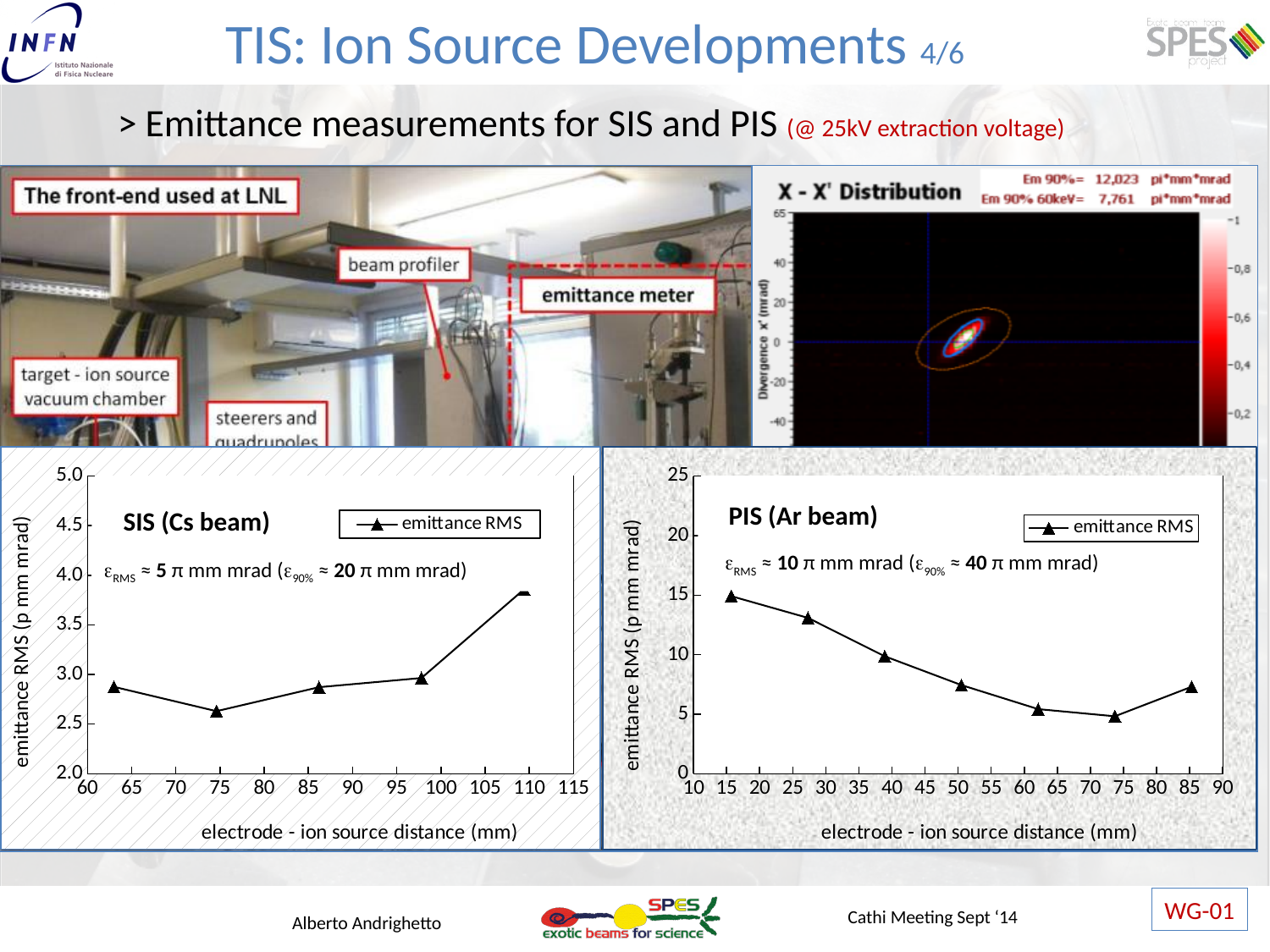
How many data points are plotted in the SIS (Cs beam) chart? 5 In the SIS (Cs beam) chart, is the highest emittance RMS found at the smallest or the largest electrode - ion source distance? largest What is the legend entry shown in the SIS (Cs beam) chart? emittance RMS What is the x-axis title of the PIS (Ar beam) chart? electrode - ion source distance (mm) In the PIS (Ar beam) chart, does the emittance RMS rise or fall as the distance increases from about 15 mm to about 75 mm? fall In the PIS (Ar beam) chart, is the emittance RMS at the leftmost point (about 15 mm) greater or less than 10? greater How many data points are plotted in the PIS (Ar beam) chart? 7 In the SIS (Cs beam) chart, is the emittance RMS at about 75 mm larger or smaller than at about 110 mm? smaller In the SIS (Cs beam) chart, is the emittance RMS at the rightmost point (about 110 mm) greater or less than 3.5? greater In the PIS (Ar beam) chart, is the emittance RMS at about 60 mm greater or less than 10? less How many series does the legend of the PIS (Ar beam) chart list? 1 What kind of chart is the SIS (Cs beam) chart? line chart